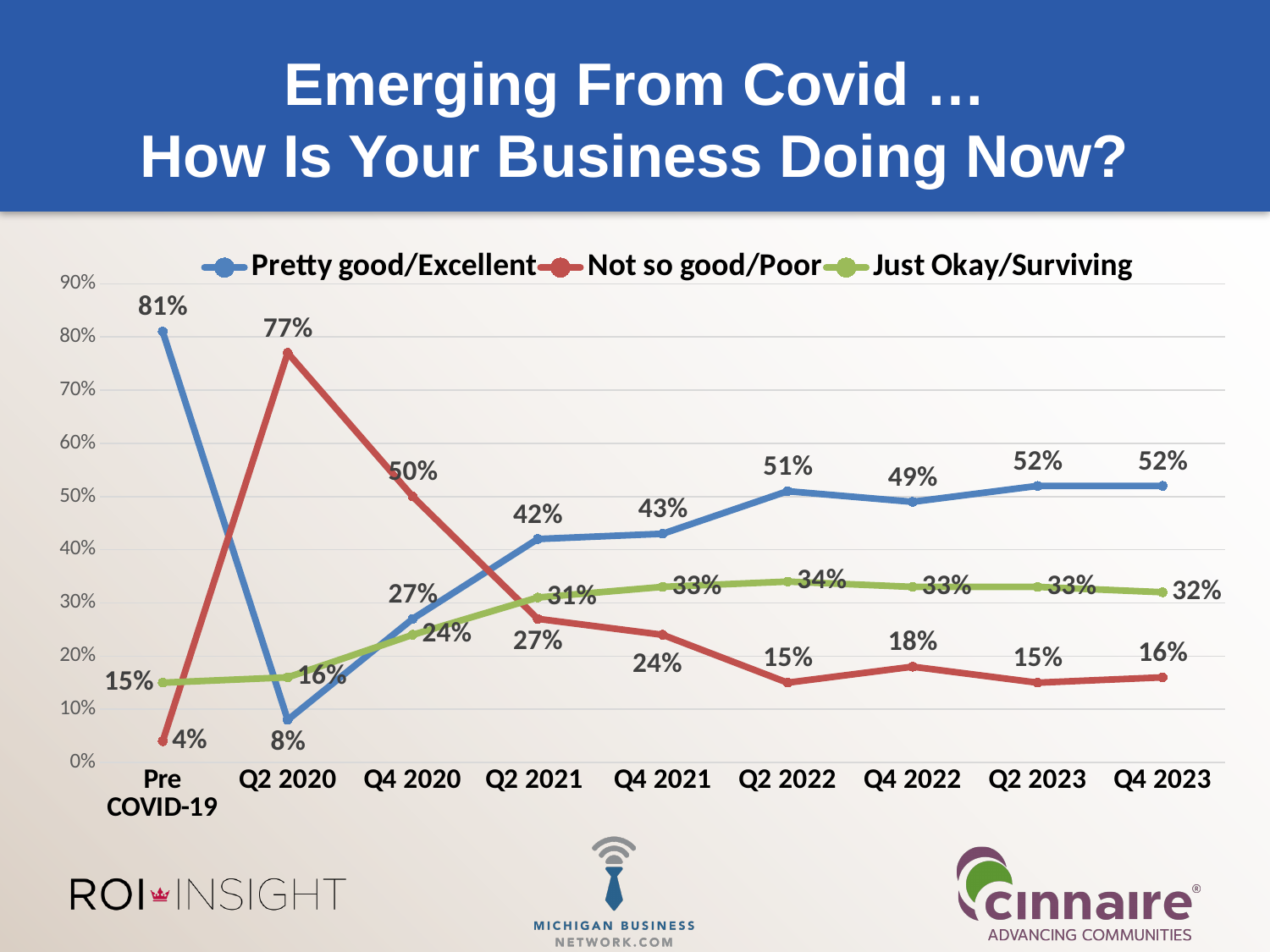
At which time point is the Pretty good/Excellent series lowest? Q2 2020 What is the value for Not so good/Poor at Q2 2020? 77% Does the Not so good/Poor series rise or fall from Q2 2020 to Q2 2022? fall What is the value for Pretty good/Excellent at Pre COVID-19? 81% How many time points are plotted along the x axis? 9 What type of chart is shown on the slide? line chart At Q4 2020, which is larger: Not so good/Poor or Pretty good/Excellent? Not so good/Poor Which colour is used for the Just Okay/Surviving series? green What is the value for Just Okay/Surviving at Q2 2022? 34% At which time point is the Not so good/Poor series highest? Q2 2020 How many series does the legend list? 3 What is the difference between Pretty good/Excellent and Not so good/Poor at Q4 2023? 36%